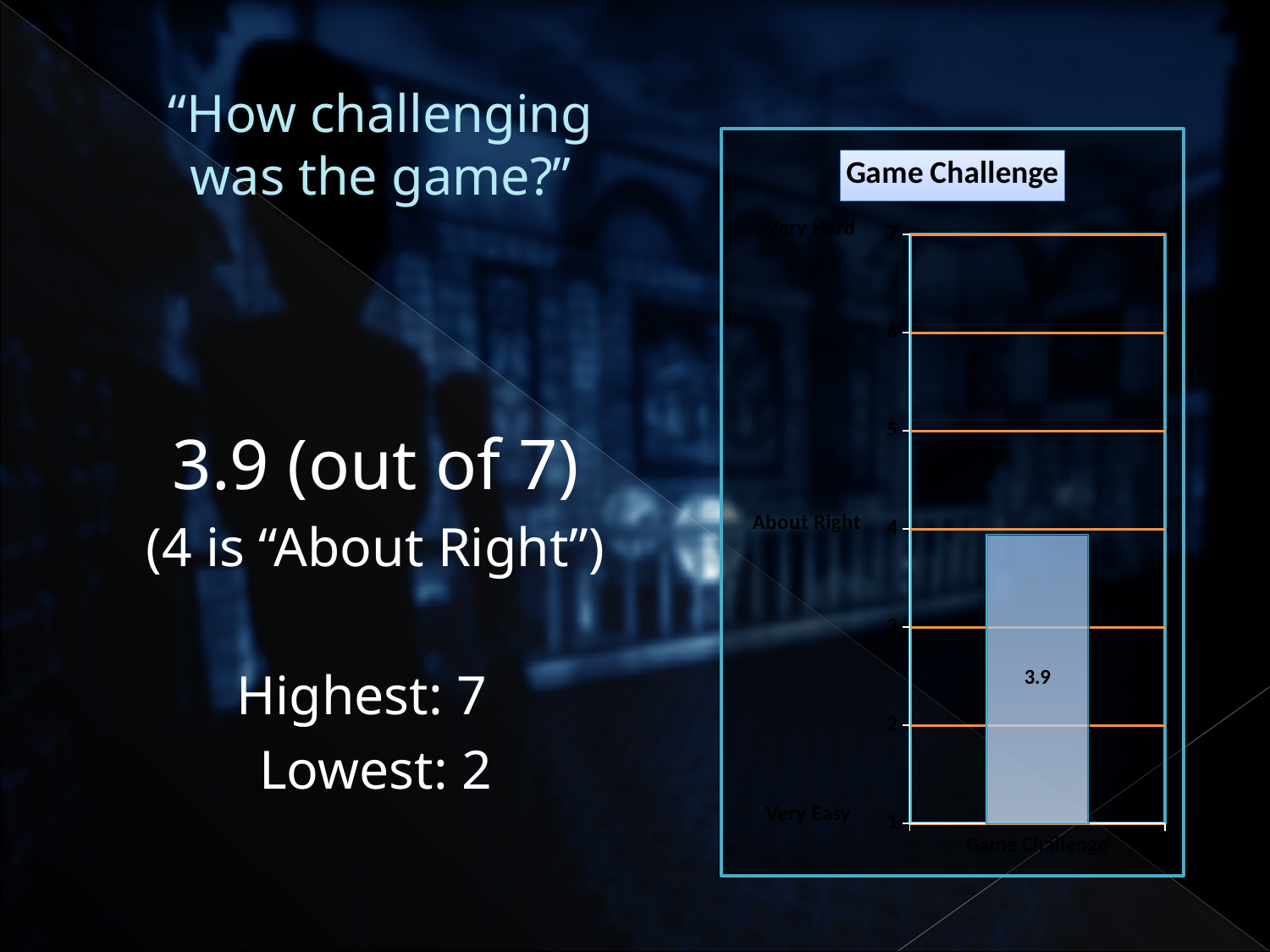
Which axis label appears next to the value 4 on the vertical axis? About Right What is the lowest value shown on the chart's vertical axis? 1 Which axis label appears next to the value 7 on the vertical axis? Very Hard What is the value of the Game Challenge bar? 3.9 Which axis label appears next to the value 1 on the vertical axis? Very Easy How many bars are plotted in the chart? 1 Is the value of the Game Challenge bar greater or less than 3? greater What type of chart is shown on the slide? bar chart What is the category label shown under the bar on the horizontal axis? Game Challenge What is the highest value shown on the chart's vertical axis? 7 What is the title of the chart? Game Challenge Is the value of the Game Challenge bar greater or less than 4? less